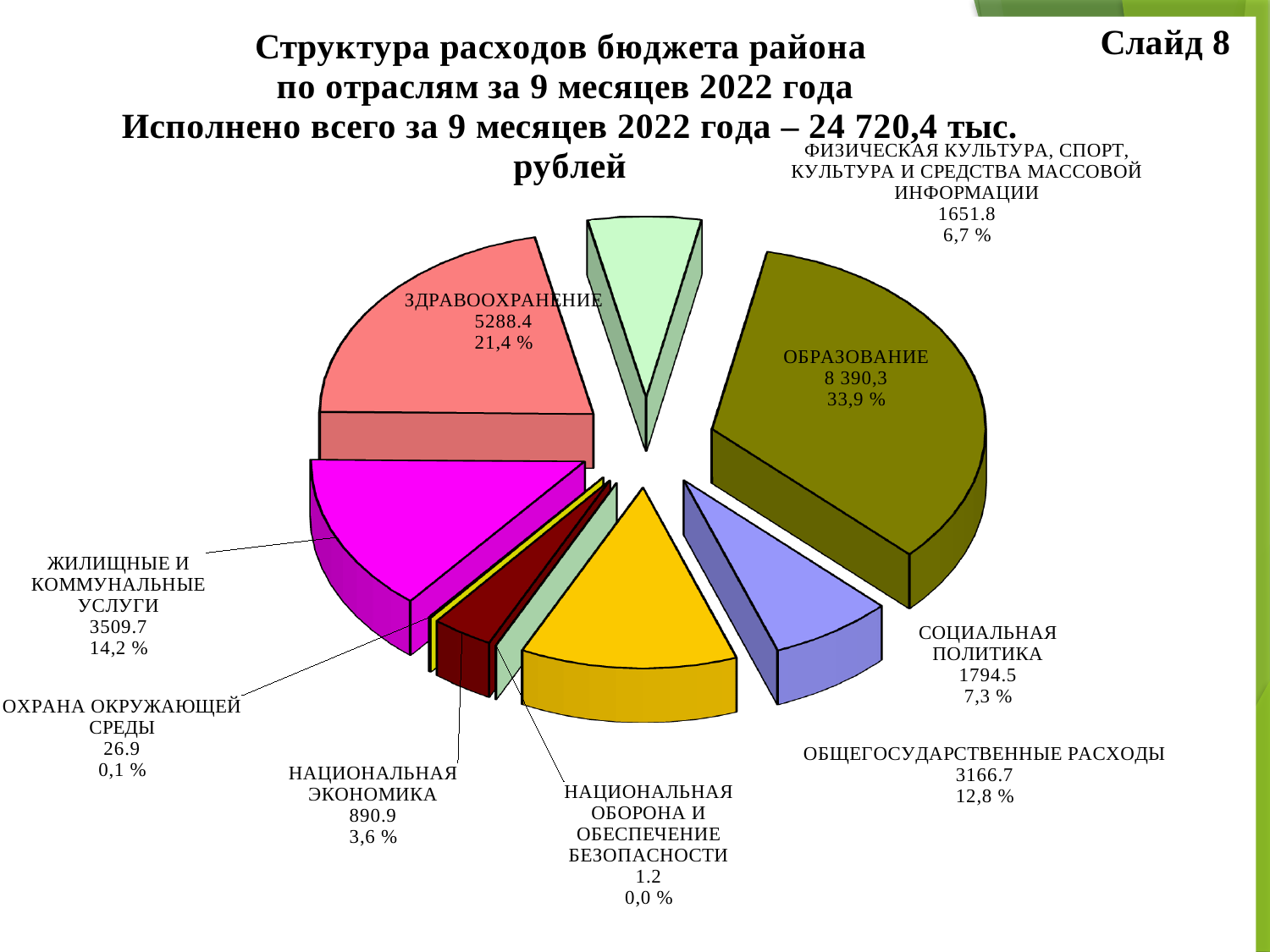
Which is larger: the value for СОЦИАЛЬНАЯ ПОЛИТИКА or the value for ФИЗИЧЕСКАЯ КУЛЬТУРА, СПОРТ, КУЛЬТУРА И СРЕДСТВА МАССОВОЙ ИНФОРМАЦИИ? СОЦИАЛЬНАЯ ПОЛИТИКА Which category has the largest share of the district budget expenditures? ОБРАЗОВАНИЕ What is the value shown for ОБЩЕГОСУДАРСТВЕННЫЕ РАСХОДЫ? 3166.7 What is the value shown for ЗДРАВООХРАНЕНИЕ? 5288.4 What percentage share does ЖИЛИЩНЫЕ И КОММУНАЛЬНЫЕ УСЛУГИ have in the pie chart? 14,2 % What percentage share does ОБРАЗОВАНИЕ have in the pie chart? 33,9 % How many categories (slices) does the pie chart show? 9 Which category has the smallest share of the district budget expenditures? НАЦИОНАЛЬНАЯ ОБОРОНА И ОБЕСПЕЧЕНИЕ БЕЗОПАСНОСТИ What is the value shown for ОХРАНА ОКРУЖАЮЩЕЙ СРЕДЫ? 26.9 According to the slide title, what is the total executed amount for 9 months of 2022? 24 720,4 тыс. рублей What kind of chart is shown on the slide? pie chart What is the difference between the values for ЗДРАВООХРАНЕНИЕ and ЖИЛИЩНЫЕ И КОММУНАЛЬНЫЕ УСЛУГИ? 1778.7